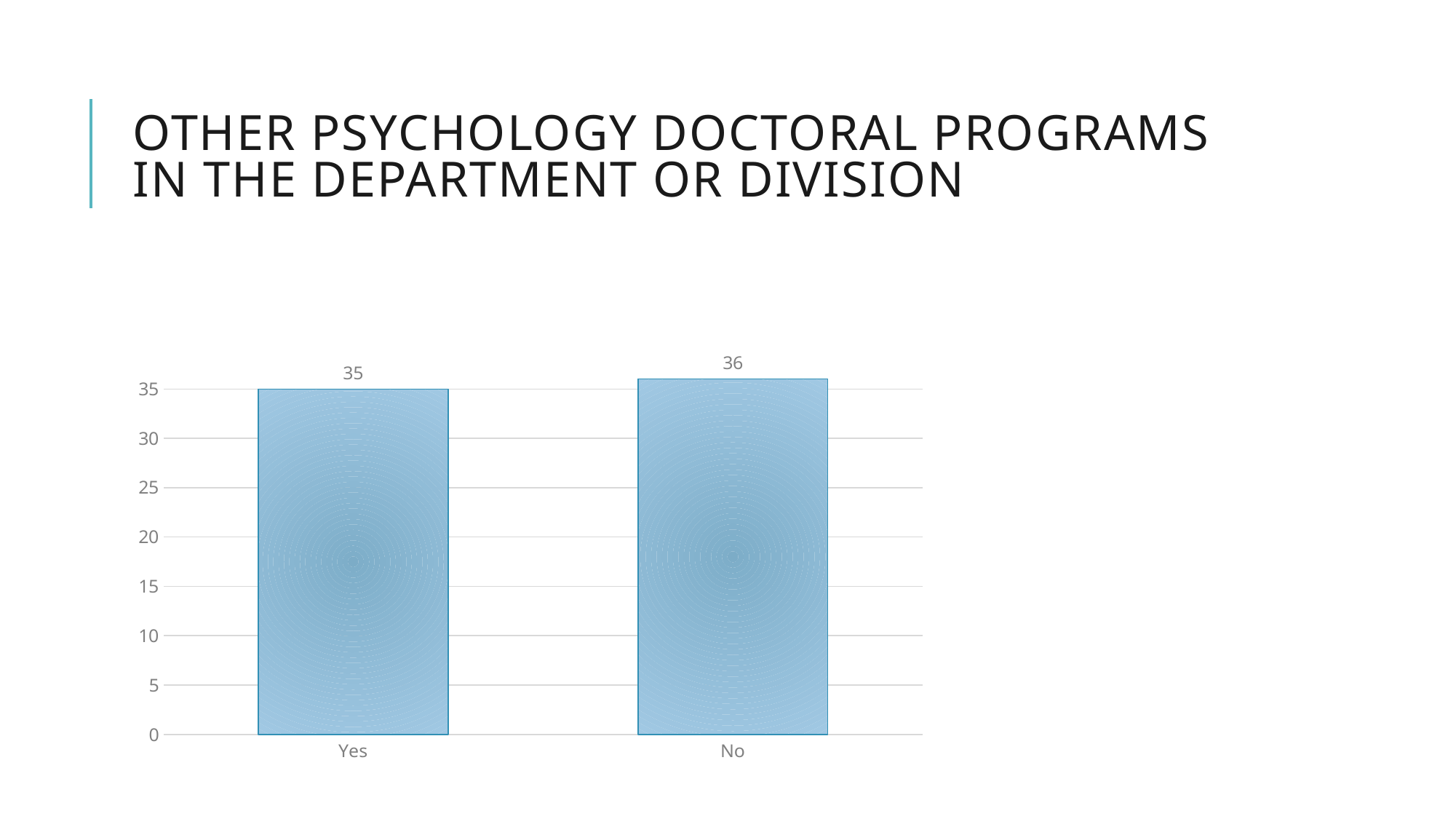
What kind of chart is shown on the slide? bar chart Is the value for Yes greater or less than 30? greater What is the value for No? 36 How many categories are shown on the x axis? 2 Which category has the lowest value? Yes What is the title of the slide? Other Psychology Doctoral Programs in the Department or Division What is the highest tick value shown on the y axis? 35 What is the value for Yes? 35 Which is larger, the value for Yes or the value for No? No Which category has the highest value? No What is the total of the values for Yes and No? 71 What is the difference between the values for No and Yes? 1